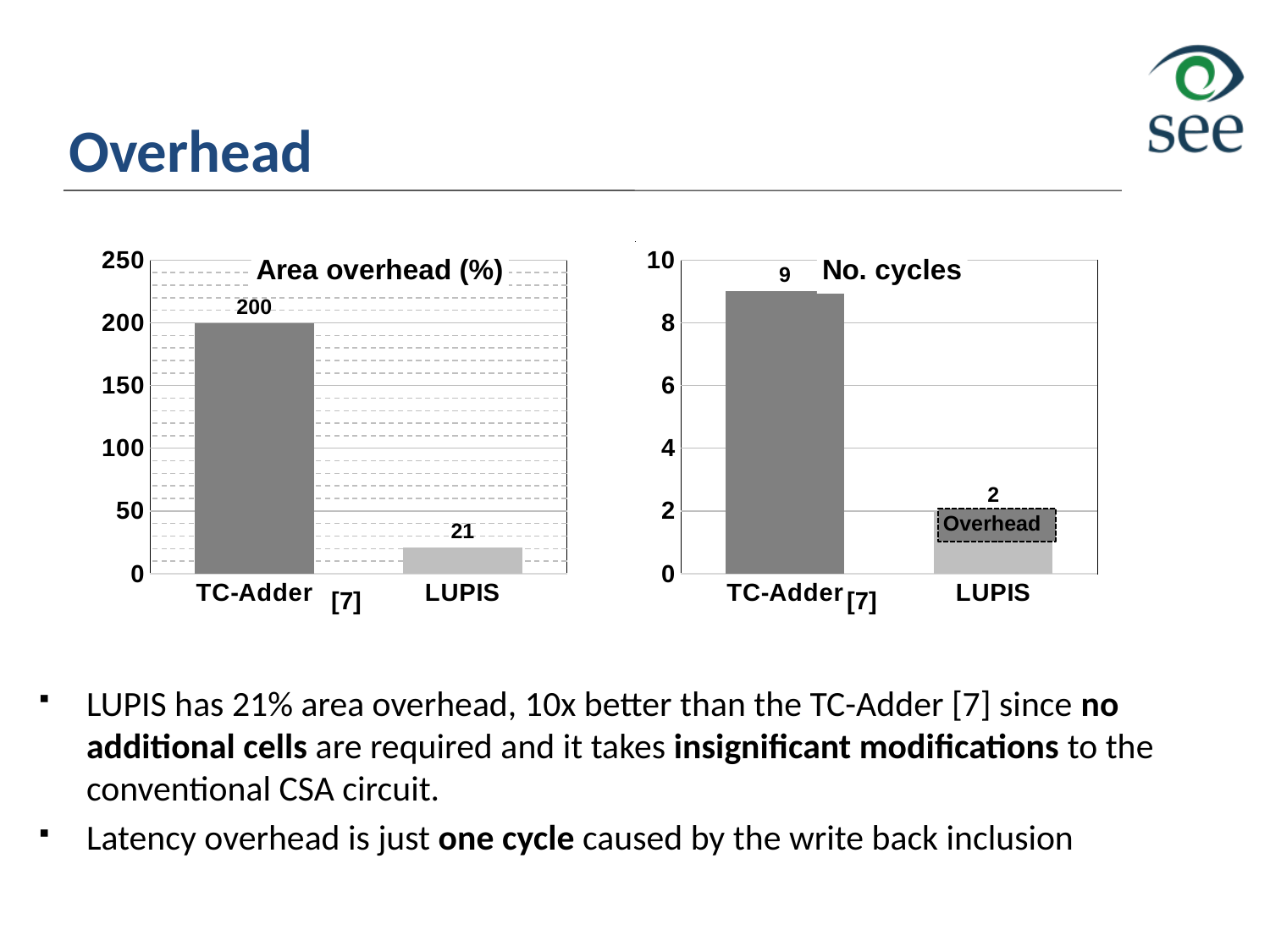
In the 'Area overhead (%)' chart, what is the value for TC-Adder? 200 In the 'No. cycles' chart, what is the value for TC-Adder? 9 What kind of chart is the 'No. cycles' chart? bar chart In the 'Area overhead (%)' chart, is the value for LUPIS greater or less than 50? less How many categories are shown in the 'Area overhead (%)' chart? 2 In the 'No. cycles' chart, which category has the lowest value? LUPIS In the 'Area overhead (%)' chart, which category has the highest value? TC-Adder In the 'No. cycles' chart, which is larger, the value for TC-Adder or for LUPIS? TC-Adder In the 'Area overhead (%)' chart, what is the difference between the TC-Adder and LUPIS values? 179 In the 'No. cycles' chart, what is the value for LUPIS? 2 In the 'Area overhead (%)' chart, what is the value for LUPIS? 21 In the 'No. cycles' chart, what is the difference between the TC-Adder and LUPIS values? 7